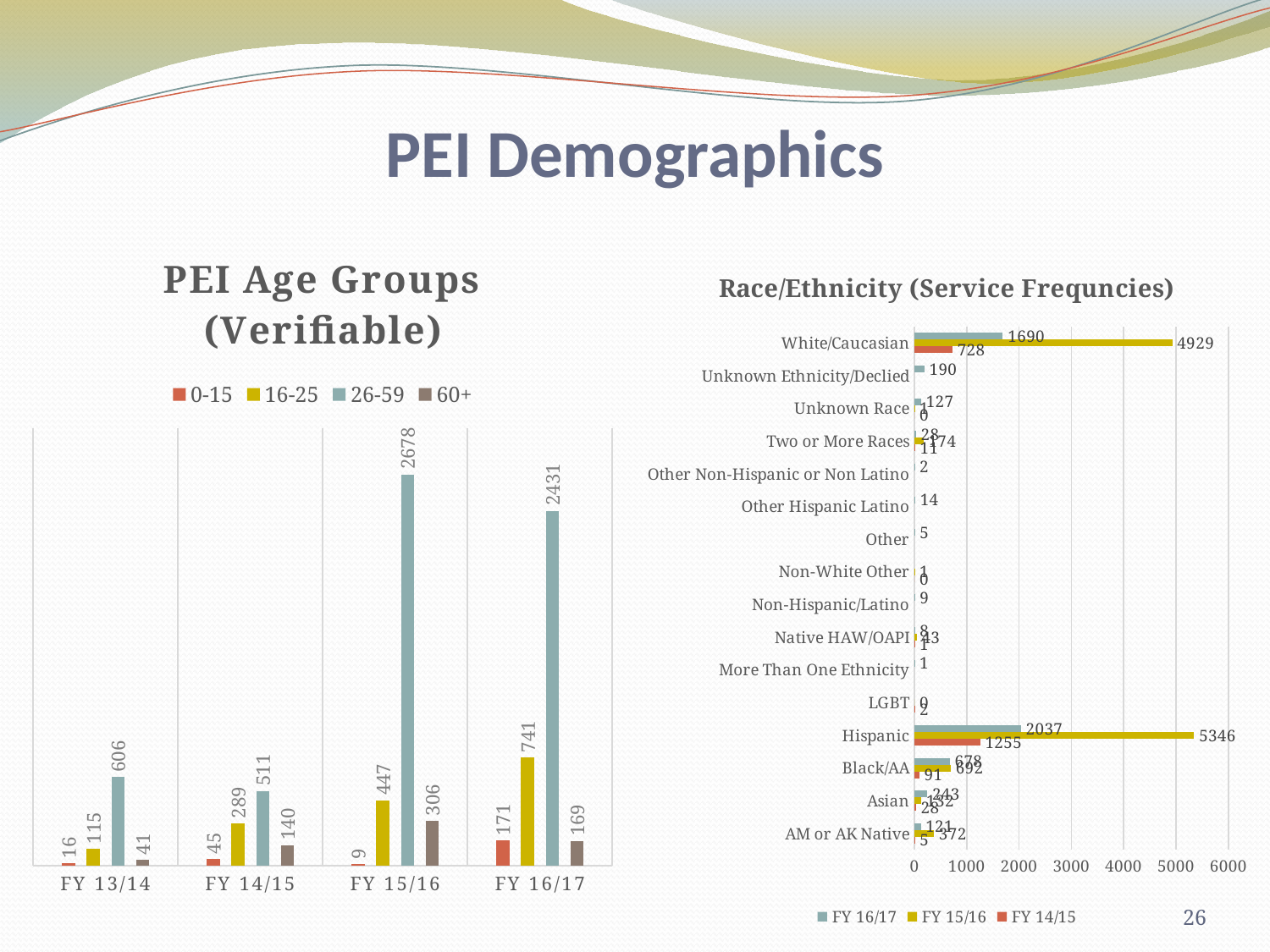
In the PEI Age Groups (Verifiable) chart, which fiscal year has the highest value for the 26-59 group? FY 15/16 In the Race/Ethnicity (Service Frequncies) chart, which is larger: the FY 16/17 value for Hispanic or the FY 16/17 value for White/Caucasian? Hispanic In the Race/Ethnicity (Service Frequncies) chart, what is the FY 15/16 value for Hispanic? 5346 In the PEI Age Groups (Verifiable) chart, what is the value for the 60+ group in FY 14/15? 140 In the PEI Age Groups (Verifiable) chart, which fiscal year has the lowest value for the 0-15 group? FY 15/16 What kind of chart is the Race/Ethnicity (Service Frequncies) chart? bar chart In the Race/Ethnicity (Service Frequncies) chart, what is the FY 14/15 value for White/Caucasian? 728 In the PEI Age Groups (Verifiable) chart, what is the difference between the 26-59 values for FY 15/16 and FY 16/17? 247 In the PEI Age Groups (Verifiable) chart, what is the value for the 16-25 group in FY 16/17? 741 In the PEI Age Groups (Verifiable) chart, does the 16-25 value rise or fall from FY 13/14 to FY 16/17? rise In the PEI Age Groups (Verifiable) chart, what is the value for the 26-59 group in FY 15/16? 2678 How many series does the legend of the PEI Age Groups (Verifiable) chart list? 4